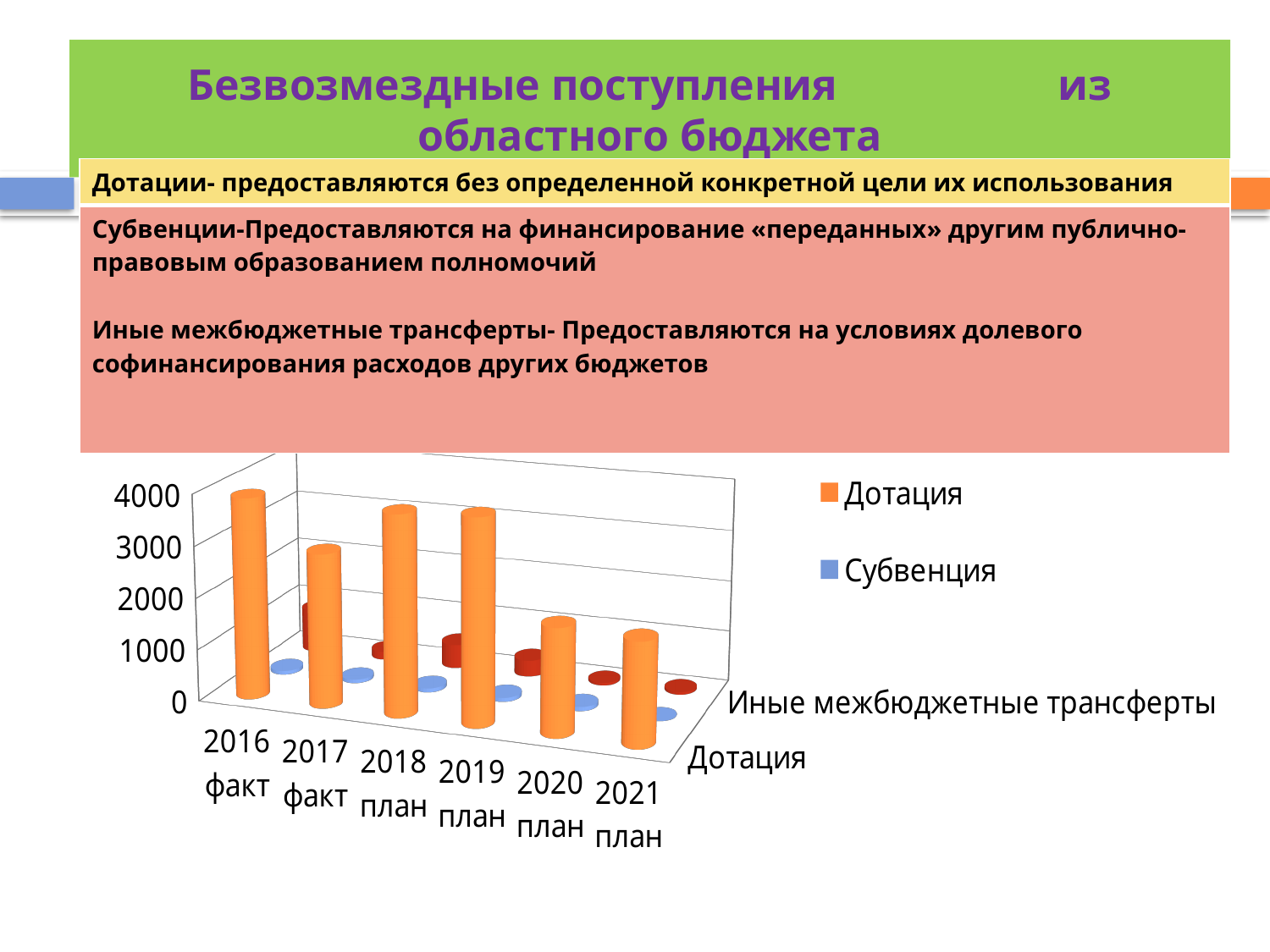
What colour are the Субвенция bars in the chart? blue Which is larger, the Дотация value for 2016 факт or for 2021 план? 2016 факт Which is larger for 2019 план, the Дотация value or the Субвенция value? Дотация How many year categories are shown along the x axis of the chart? 6 Is the Дотация value for 2016 факт greater or less than 3000? greater What colour are the Дотация bars in the chart? orange Is the Субвенция value for 2016 факт greater or less than 1000? less What kind of chart is shown on the slide? bar chart